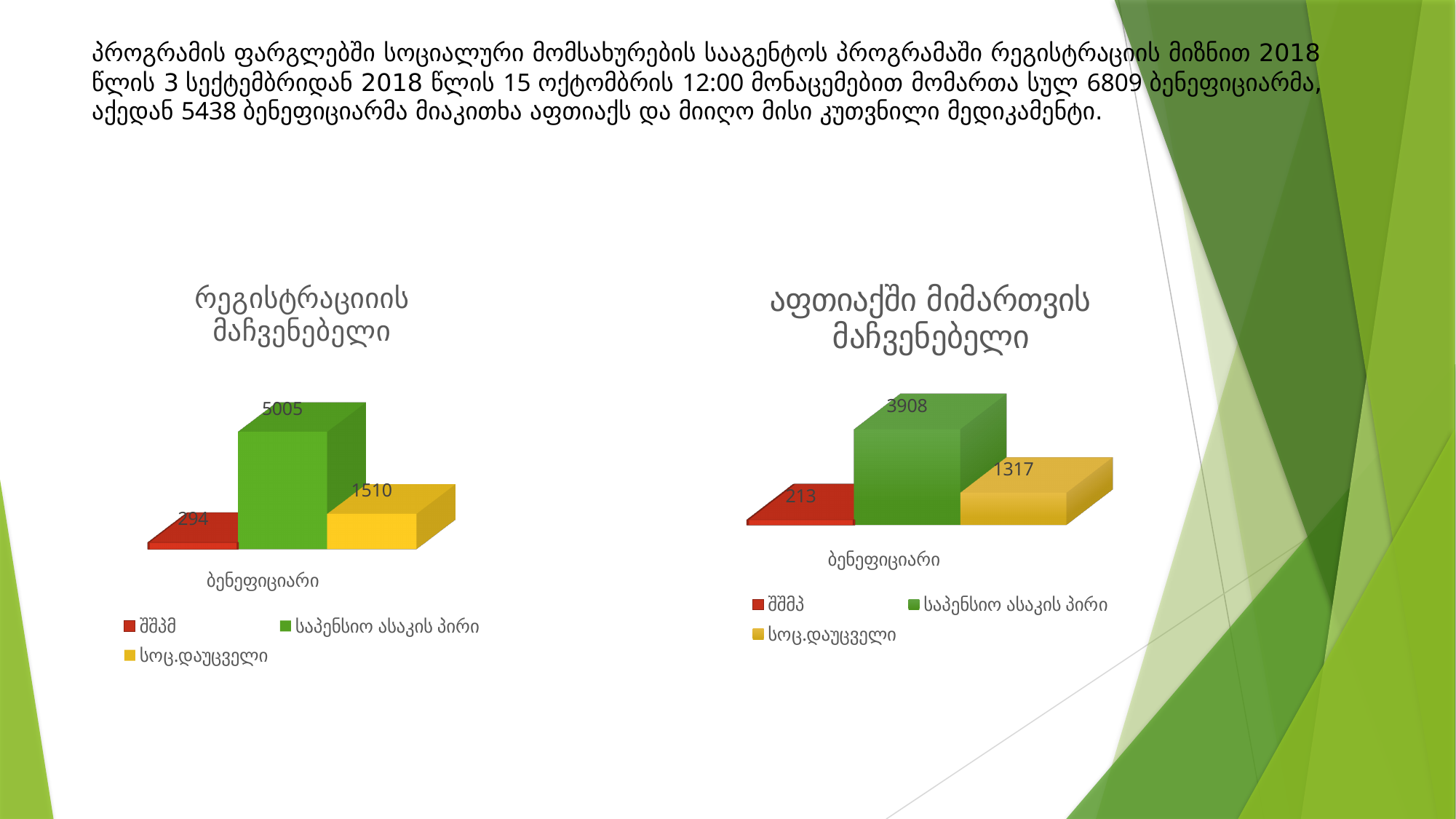
In the left chart (რეგისტრაციის მაჩვენებელი), which series has the highest value? საპენსიო ასაკის პირი In the right chart (აფთიაქში მიმართვის მაჩვენებელი), what is the difference between the values for სოც.დაუცველი and შშმპ? 1104 In the right chart (აფთიაქში მიმართვის მაჩვენებელი), which series has the lowest value? შშმპ What kind of chart is the left chart (რეგისტრაციის მაჩვენებელი)? Bar chart In the left chart (რეგისტრაციის მაჩვენებელი), what is the value for შშმპ? 294 In the left chart (რეგისტრაციის მაჩვენებელი), what is the value for საპენსიო ასაკის პირი? 5005 What colour represents საპენსიო ასაკის პირი in both charts? Green In the right chart (აფთიაქში მიმართვის მაჩვენებელი), what is the value for საპენსიო ასაკის პირი? 3908 In the right chart (აფთიაქში მიმართვის მაჩვენებელი), what is the value for სოც.დაუცველი? 1317 How many series does the legend of the right chart (აფთიაქში მიმართვის მაჩვენებელი) list? 3 In the left chart (რეგისტრაციის მაჩვენებელი), what is the difference between the values for საპენსიო ასაკის პირი and სოც.დაუცველი? 3495 Which is larger: the value for სოც.დაუცველი in the left chart or the value for სოც.დაუცველი in the right chart? The left chart (1510)